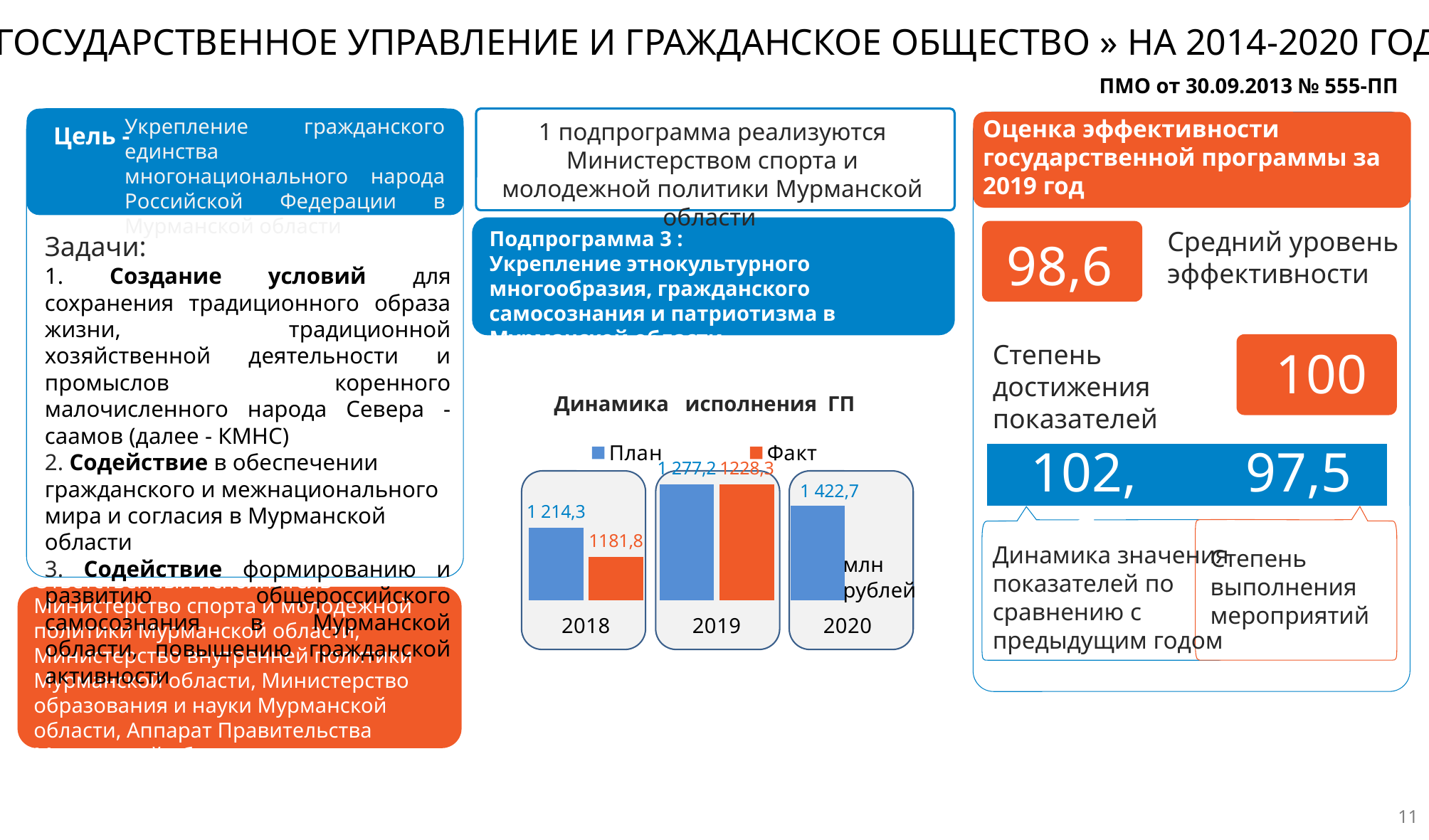
In the 'Динамика исполнения ГП' chart, which is larger for 2019: План or Факт? План Which year has the lowest Факт value in the 'Динамика исполнения ГП' chart? 2018 What is the План value for 2018 in the 'Динамика исполнения ГП' chart? 1 214,3 How many series does the legend of the 'Динамика исполнения ГП' chart list? 2 What is the Факт value for 2019 in the 'Динамика исполнения ГП' chart? 1228,3 Does the План value rise or fall from 2018 to 2020 in the 'Динамика исполнения ГП' chart? Rise What is the План value for 2020 in the 'Динамика исполнения ГП' chart? 1 422,7 Which year has the highest План value in the 'Динамика исполнения ГП' chart? 2020 What kind of chart is 'Динамика исполнения ГП'? Bar chart What is the Факт value for 2018 in the 'Динамика исполнения ГП' chart? 1181,8 How many years are shown on the x axis of the 'Динамика исполнения ГП' chart? 3 What is the План value for 2019 in the 'Динамика исполнения ГП' chart? 1 277,2